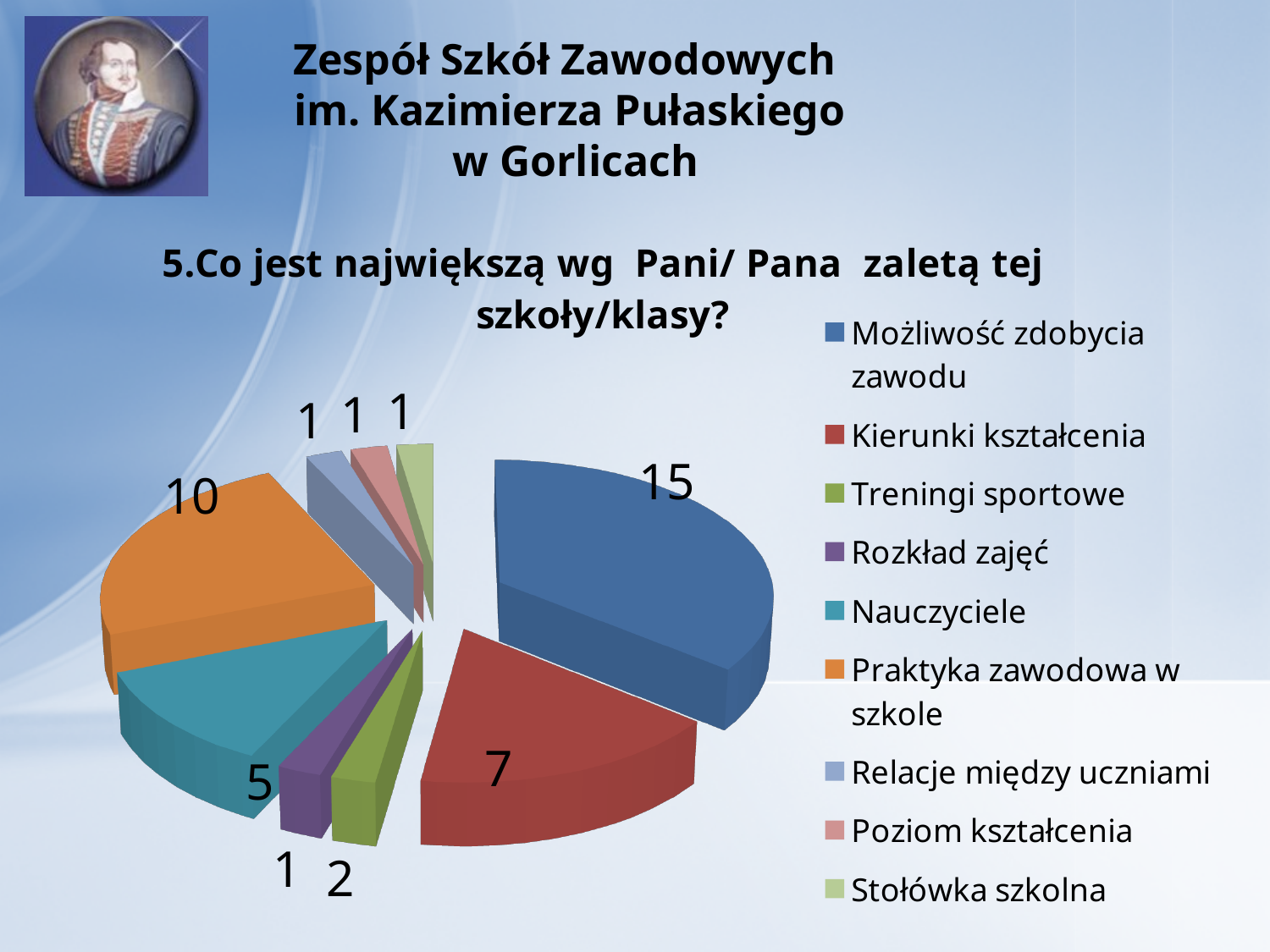
What is the value for Praktyka zawodowa w szkole? 10 What is the value for Kierunki kształcenia? 7 How many categories have a value of 1? 4 What colour is the slice for Praktyka zawodowa w szkole? orange Which is larger, the value for Kierunki kształcenia or the value for Nauczyciele? Kierunki kształcenia How many categories does the legend list? 9 What kind of chart is shown on the slide? pie chart What is the value for Możliwość zdobycia zawodu? 15 Which category has the largest slice of the pie? Możliwość zdobycia zawodu What is the value for Treningi sportowe? 2 What is the difference between the values for Możliwość zdobycia zawodu and Praktyka zawodowa w szkole? 5 What is the value for Nauczyciele? 5